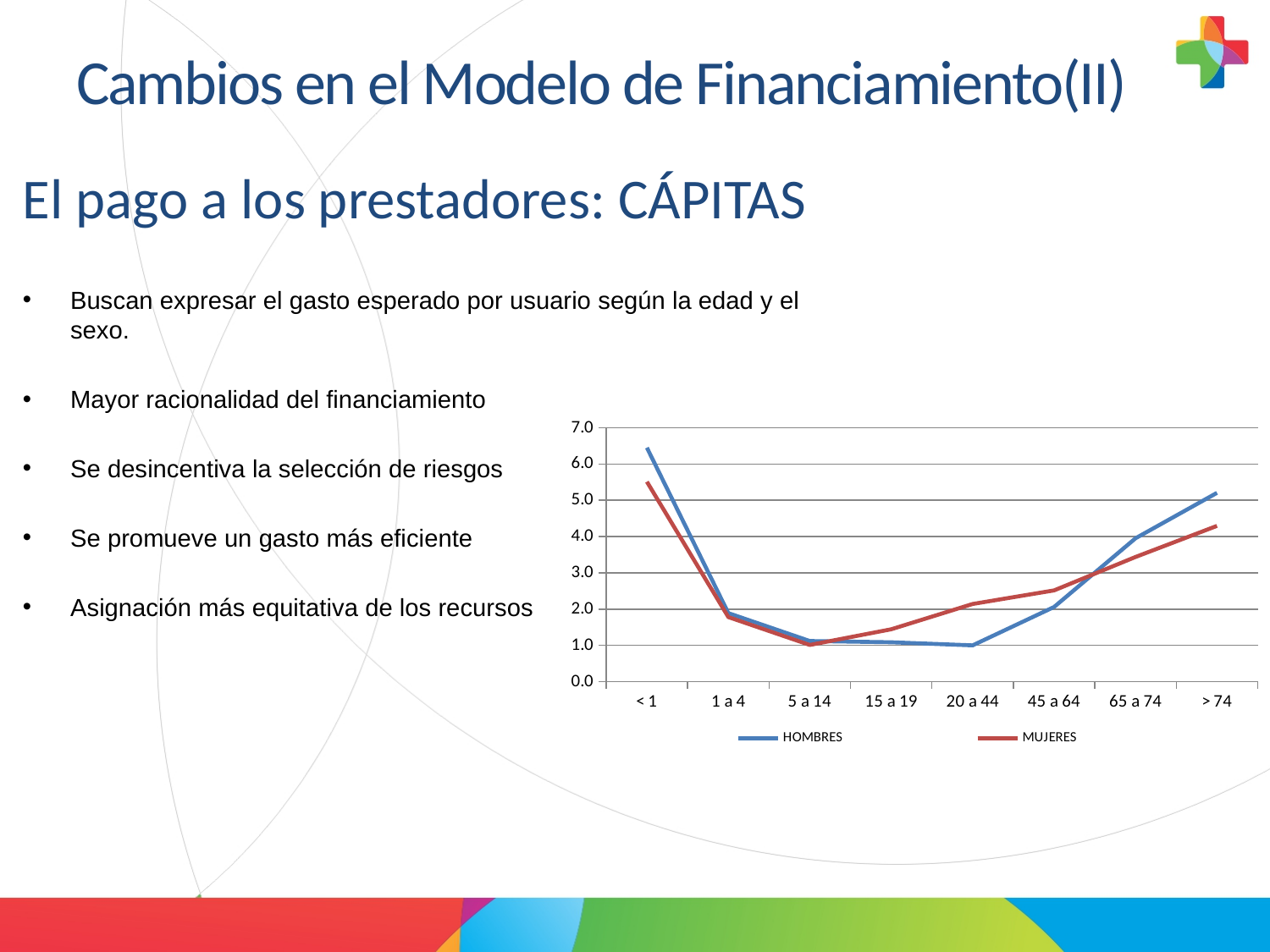
At the 20 a 44 age category, which series has the larger value, HOMBRES or MUJERES? MUJERES For which age category is the HOMBRES series highest? < 1 At the < 1 age category, which series has the larger value, HOMBRES or MUJERES? HOMBRES How many age categories are shown on the x axis of the chart? 8 Is the HOMBRES value for the 20 a 44 category greater or less than 2.0? less Is the HOMBRES value for the < 1 category greater or less than 6.0? greater For which age category is the MUJERES series highest? < 1 Does the HOMBRES series rise or fall from the 20 a 44 category to the > 74 category? Rise What kind of chart is shown on the slide? Line chart For which age category is the MUJERES series lowest? 5 a 14 At the > 74 age category, which series has the larger value, HOMBRES or MUJERES? HOMBRES How many series does the chart legend list? 2